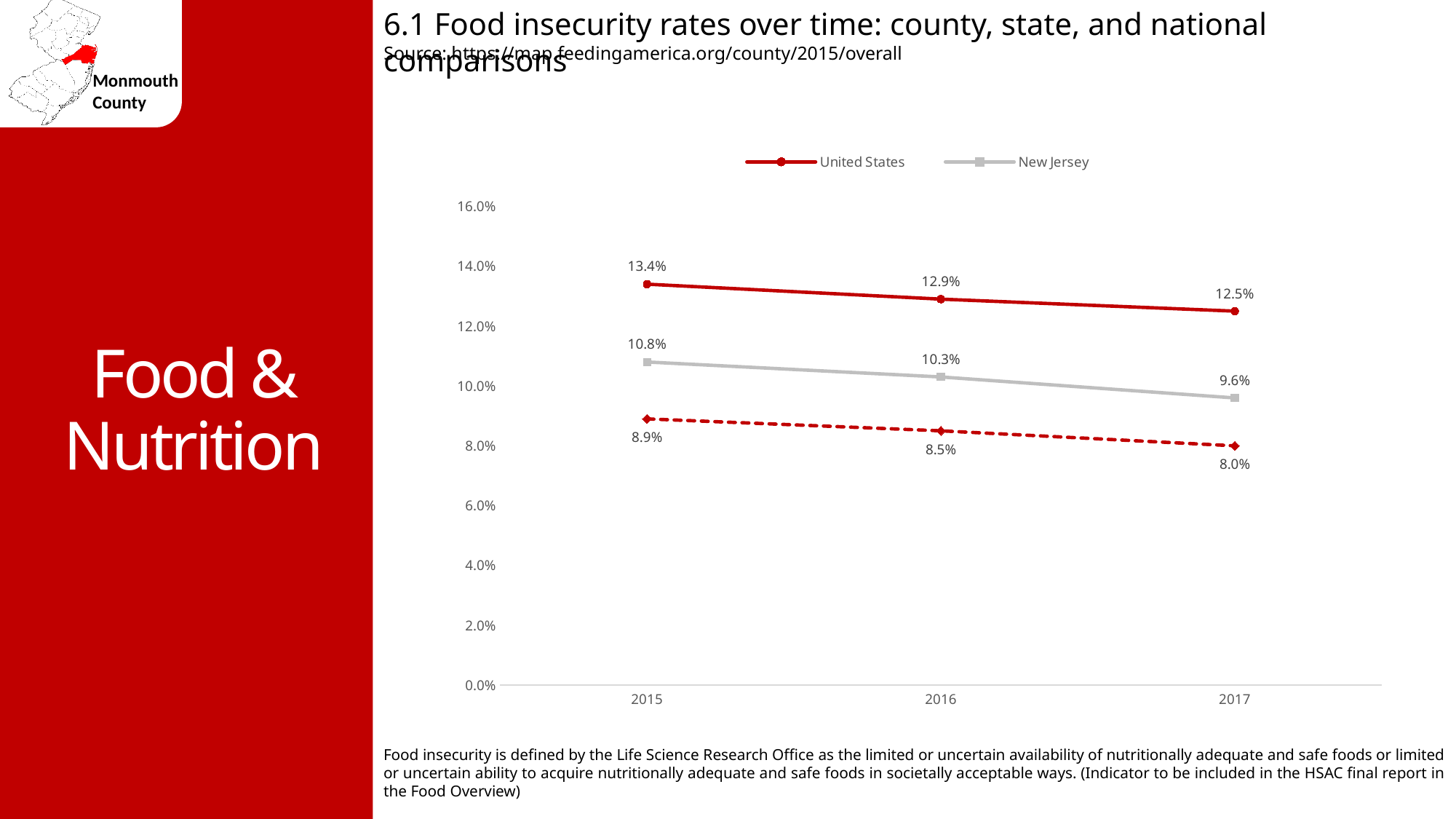
Which had a higher food insecurity rate in 2017, the United States or New Jersey? United States What was the food insecurity rate for the United States in 2016? 12.9% What is the difference between the United States and New Jersey food insecurity rates in 2015? 2.6% What was the food insecurity rate for New Jersey in 2016? 10.3% How many series does the legend list? 2 What type of chart is shown on the slide? Line chart In which year was the New Jersey food insecurity rate lowest? 2017 In which year was the United States food insecurity rate highest? 2015 Does the United States food insecurity rate rise or fall from 2015 to 2017? Fall What was the food insecurity rate for New Jersey in 2017? 9.6% By how much did the New Jersey food insecurity rate fall from 2015 to 2017? 1.2% What was the food insecurity rate for the United States in 2015? 13.4%